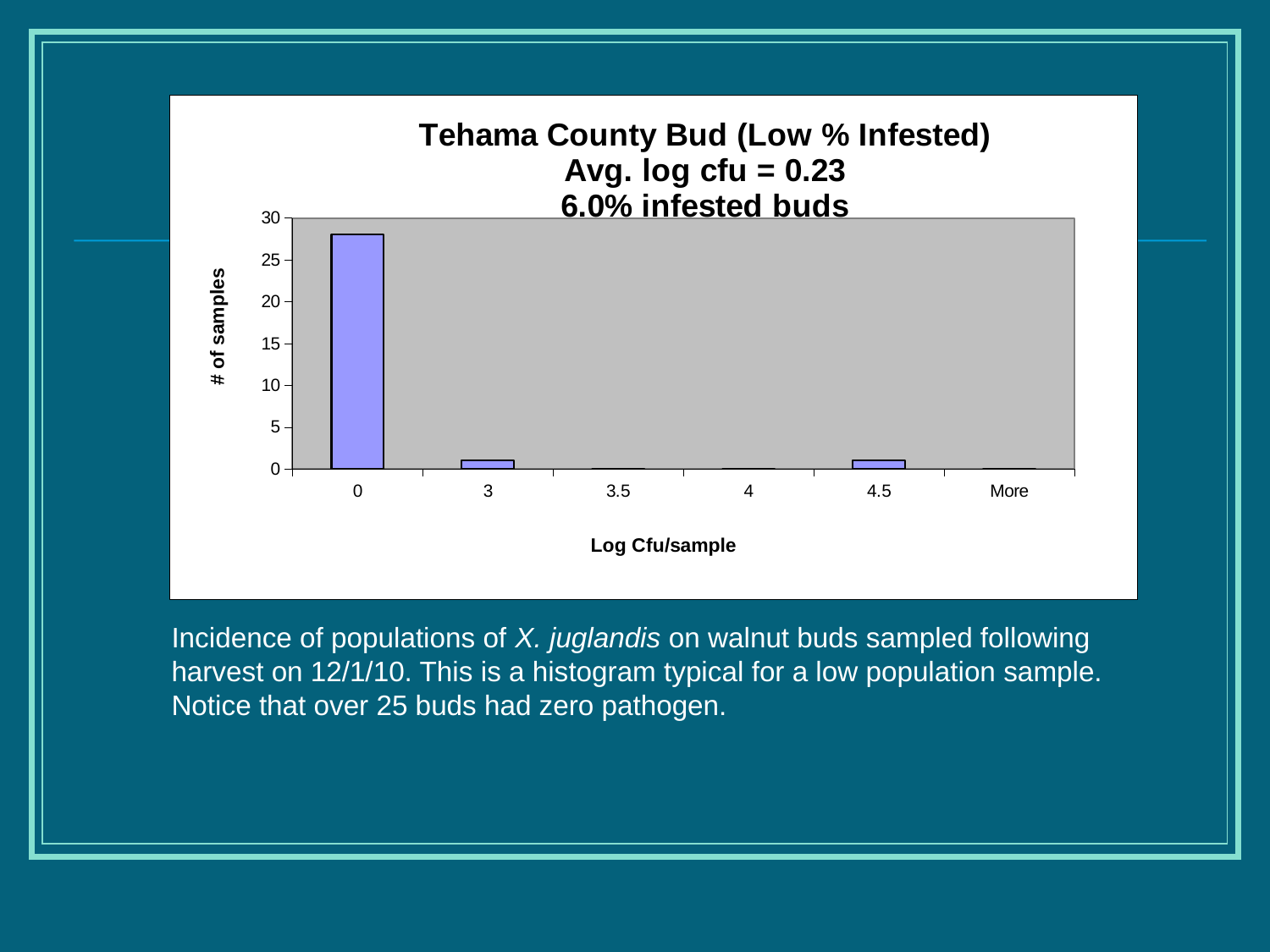
Is the number of samples for the 3 category greater or less than 5? less According to the chart title, what is the average log cfu? 0.23 Is the number of samples for the 0 category greater or less than 25? greater What is the label of the x axis of the chart? Log Cfu/sample Which has more samples, the 0 category or the 4.5 category? 0 Is the number of samples for the 4.5 category greater or less than 5? less How many categories are shown on the x axis of the chart? 6 Which has more samples, the 0 category or the 3 category? 0 Which Log Cfu/sample category has the highest number of samples? 0 What kind of chart is shown on the slide? bar chart